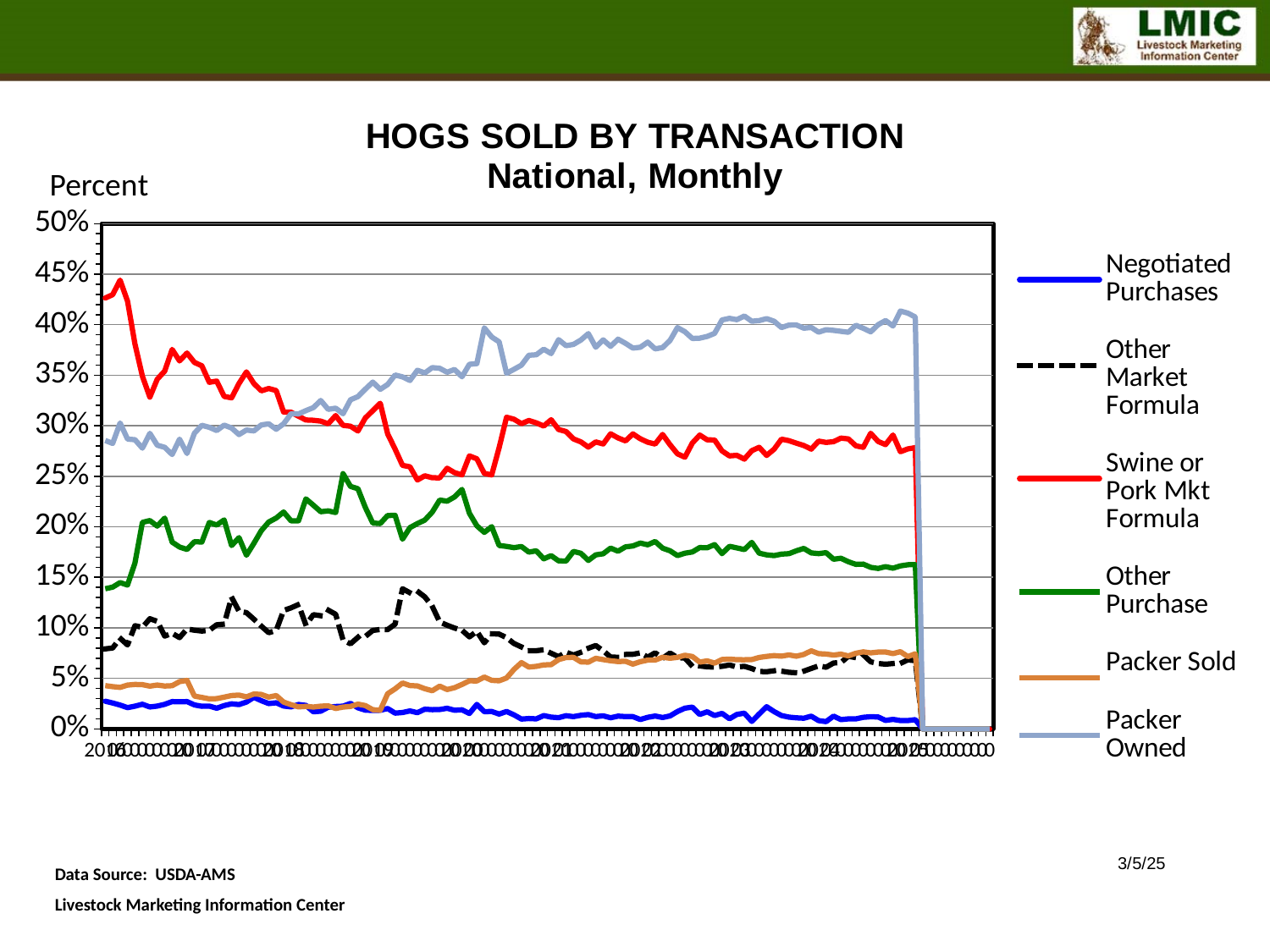
Is the value for Negotiated Purchases in 2024 greater or less than 5%? less Does the Packer Owned series rise or fall from 2016 to 2024? rise How many series does the legend list? 6 Is the value for Packer Owned at the end of 2024 greater or less than 35%? greater What is the title of the chart? HOGS SOLD BY TRANSACTION National, Monthly Which series has the highest value in 2024? Packer Owned Is the value for Other Purchase at the start of 2016 greater or less than 20%? less Which series is drawn as a dashed line? Other Market Formula Does the Swine or Pork Mkt Formula series rise or fall from 2016 to 2024? fall What kind of chart is shown on the slide? line chart Which series has the lowest values across the whole period? Negotiated Purchases At the start of 2016, which is higher: Swine or Pork Mkt Formula or Packer Owned? Swine or Pork Mkt Formula